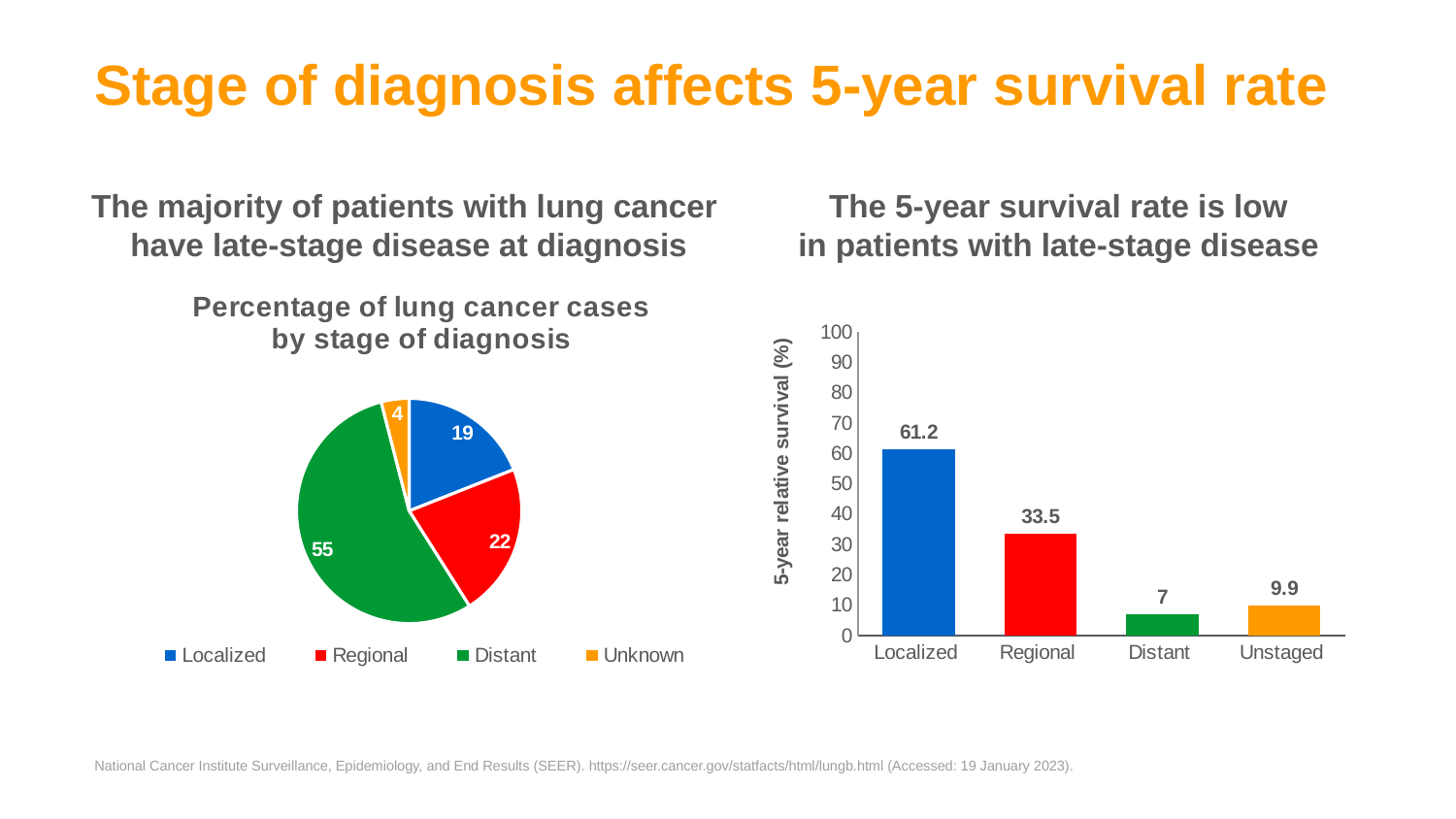
In the pie chart 'Percentage of lung cancer cases by stage of diagnosis', which stage has the smallest slice? Unknown What type of chart is shown on the right side of the slide? Bar chart In the pie chart 'Percentage of lung cancer cases by stage of diagnosis', what is the difference between the Distant and Regional values? 33 In the bar chart on the right, which stage has the highest 5-year relative survival? Localized In the pie chart 'Percentage of lung cancer cases by stage of diagnosis', which stage has the largest slice? Distant In the bar chart on the right, which stage has the lowest 5-year relative survival? Distant In the pie chart 'Percentage of lung cancer cases by stage of diagnosis', what is the value for Localized? 19 In the bar chart on the right, what is the difference between the Localized and Regional values? 27.7 In the pie chart 'Percentage of lung cancer cases by stage of diagnosis', what is the value for Distant? 55 In the bar chart on the right, what is the 5-year relative survival for Distant? 7 In the pie chart 'Percentage of lung cancer cases by stage of diagnosis', how many slices are there? 4 In the bar chart on the right, what is the 5-year relative survival for Regional? 33.5